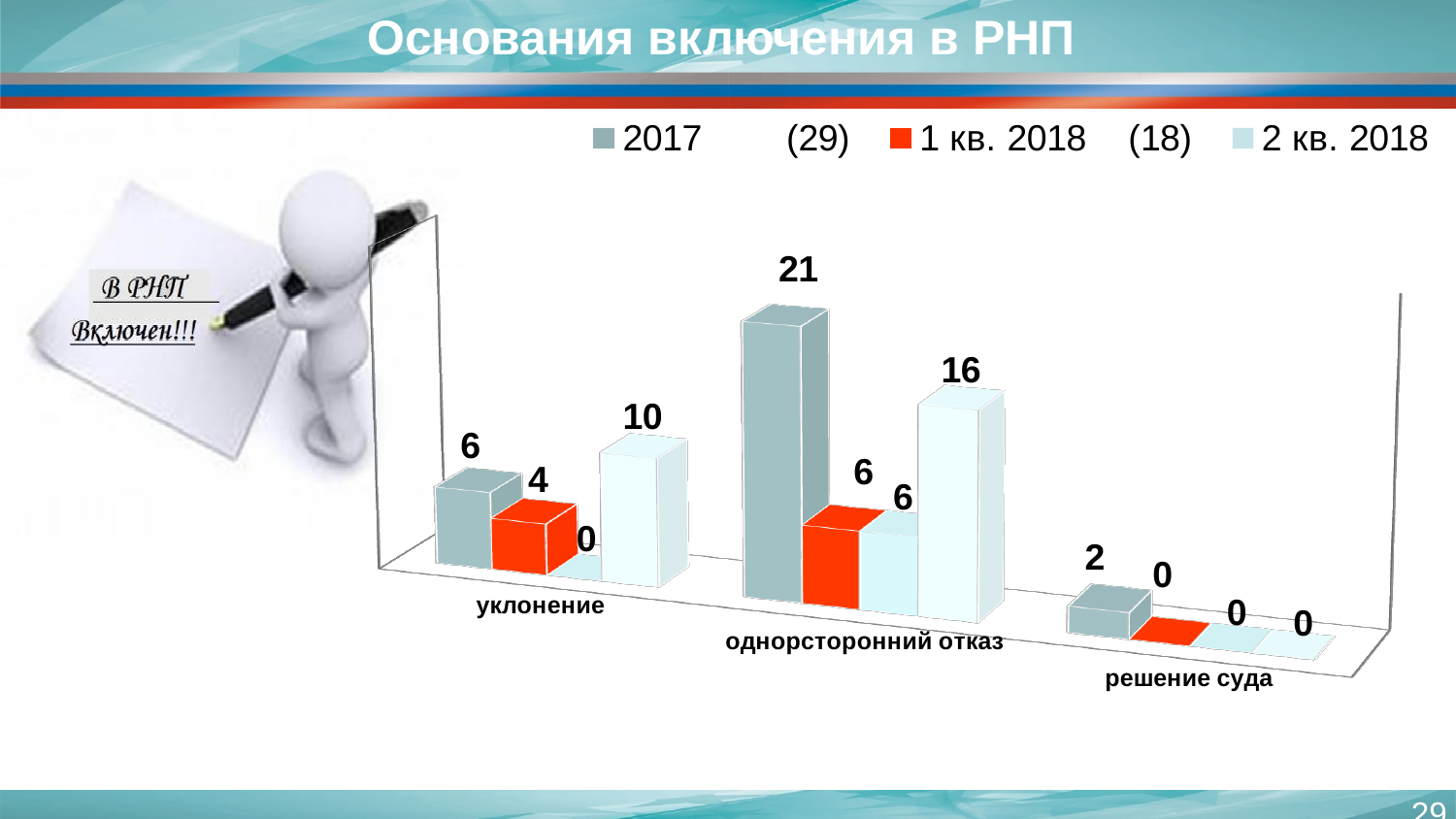
How many categories are shown on the x axis? 3 What is the 1 кв. 2018 value for уклонение? 4 Which category has the highest 2017 value? односторонний отказ What is the 1 кв. 2018 value for односторонний отказ? 6 What is the difference between the 2017 values for односторонний отказ and уклонение? 15 What is the 1 кв. 2018 value for решение суда? 0 For уклонение, which is larger: the 2017 value or the 1 кв. 2018 value? 2017 What is the 2017 value for односторонний отказ? 21 What kind of chart is shown on the slide? bar chart What is the 2017 value for решение суда? 2 Which category has the lowest 2017 value? решение суда What is the 2017 value for уклонение? 6